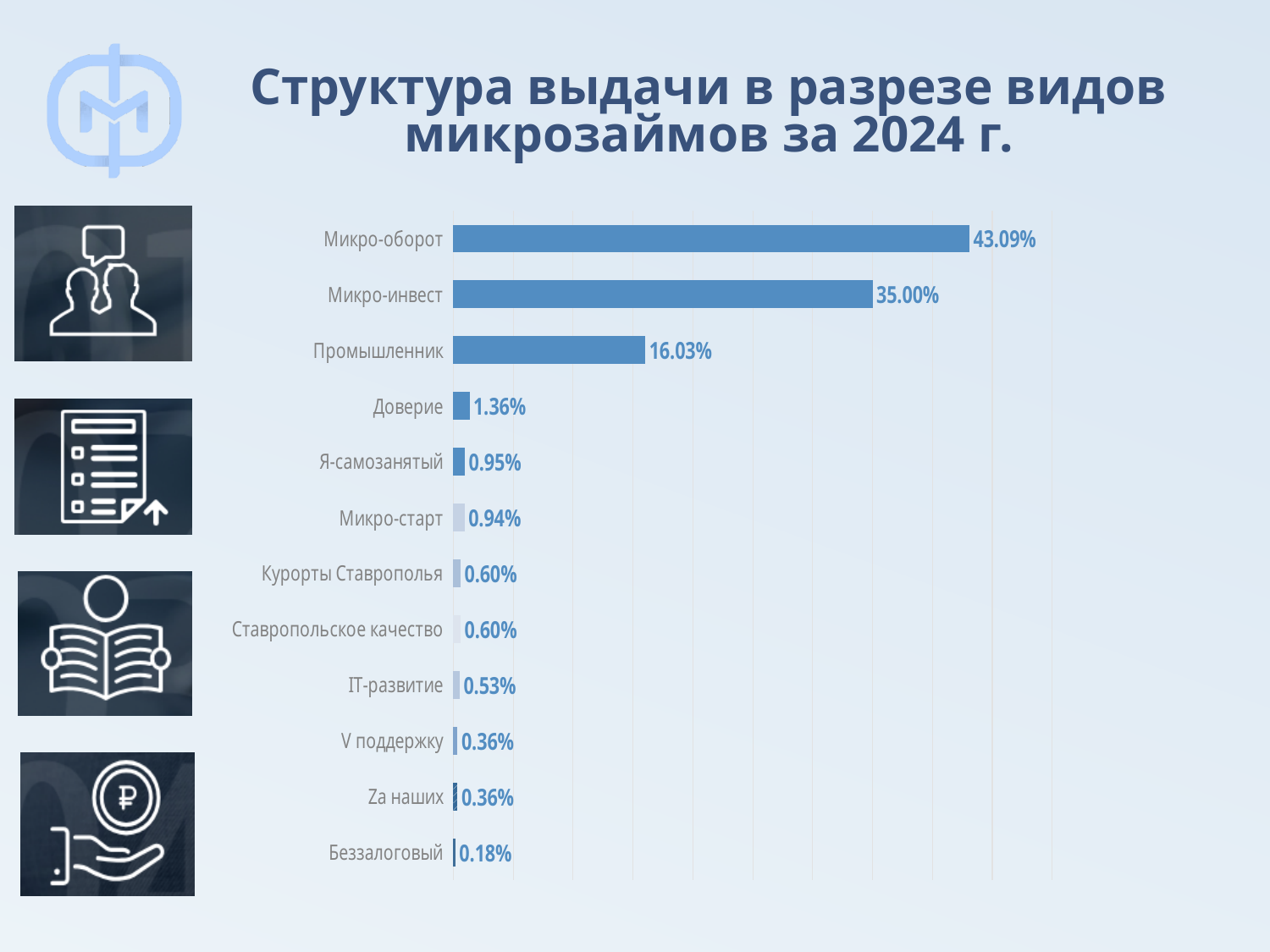
What is the value for IT-развитие? 0.53% What kind of chart is shown on the slide? Bar chart What is the difference between the values for Микро-оборот and Микро-инвест? 8.09% Which category has the lowest value? Беззалоговый What is the value for Микро-оборот? 43.09% Which category has the highest value? Микро-оборот What is the value for Доверие? 1.36% What is the title of the chart? Структура выдачи в разрезе видов микрозаймов за 2024 г. What is the value for Промышленник? 16.03% What is the value for Беззалоговый? 0.18% Which is larger, the value for Я-самозанятый or the value for Микро-старт? Я-самозанятый How many categories are shown in the chart? 12